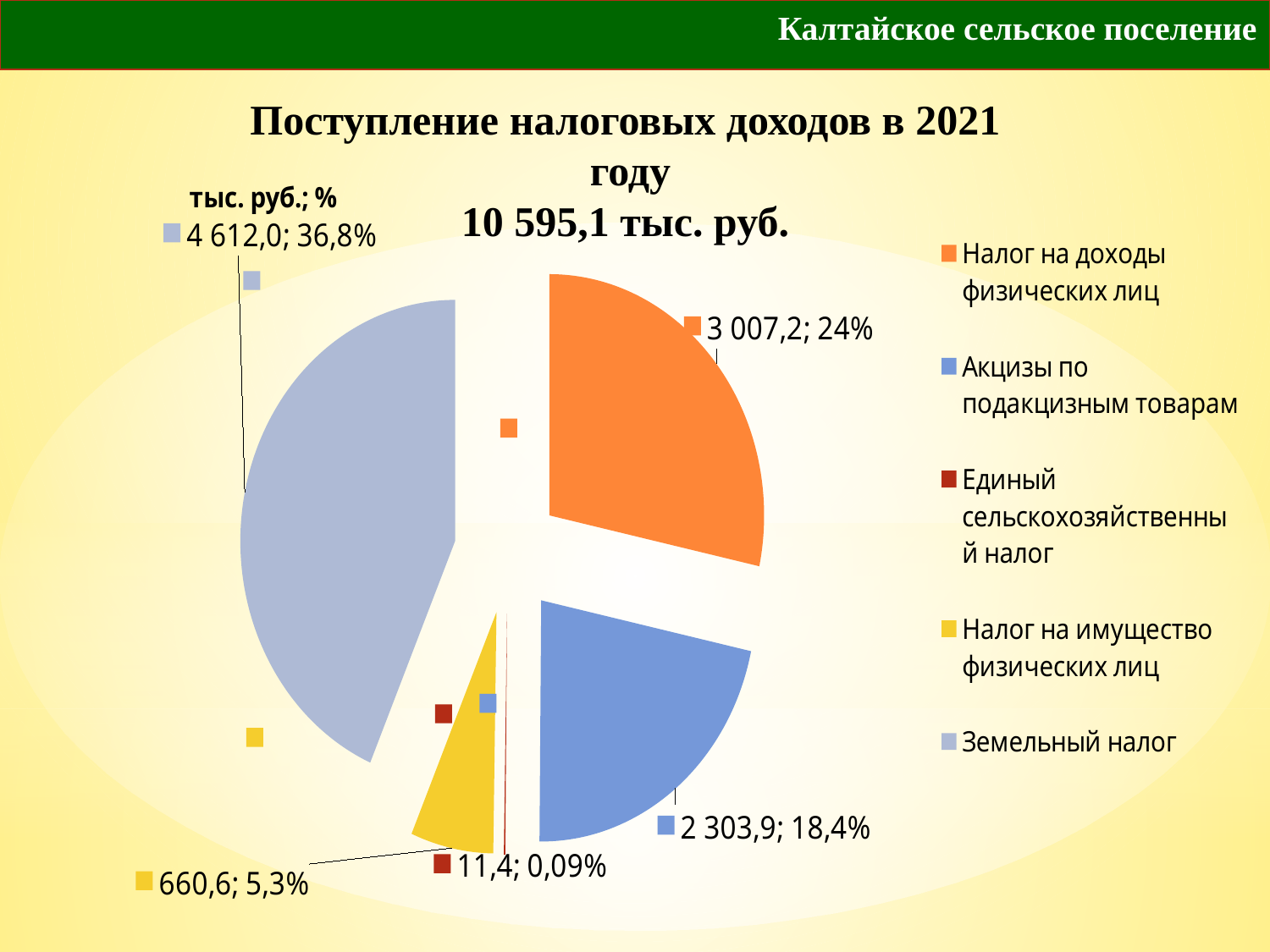
Which category has the smallest slice? Единый сельскохозяйственный налог What total amount is stated in the chart title? 10 595,1 тыс. руб. How many categories does the pie chart have? 5 Which category has the largest slice? Земельный налог What is the value for Налог на доходы физических лиц? 3 007,2 What share of the pie does Земельный налог have? 36,8% What is the value for Акцизы по подакцизным товарам? 2 303,9 What kind of chart is shown on the slide? Pie chart What is the value for Земельный налог? 4 612,0 What is the value for Единый сельскохозяйственный налог? 11,4 Which is larger: Налог на доходы физических лиц or Акцизы по подакцизным товарам? Налог на доходы физических лиц What share of the pie does Налог на имущество физических лиц have? 5,3%